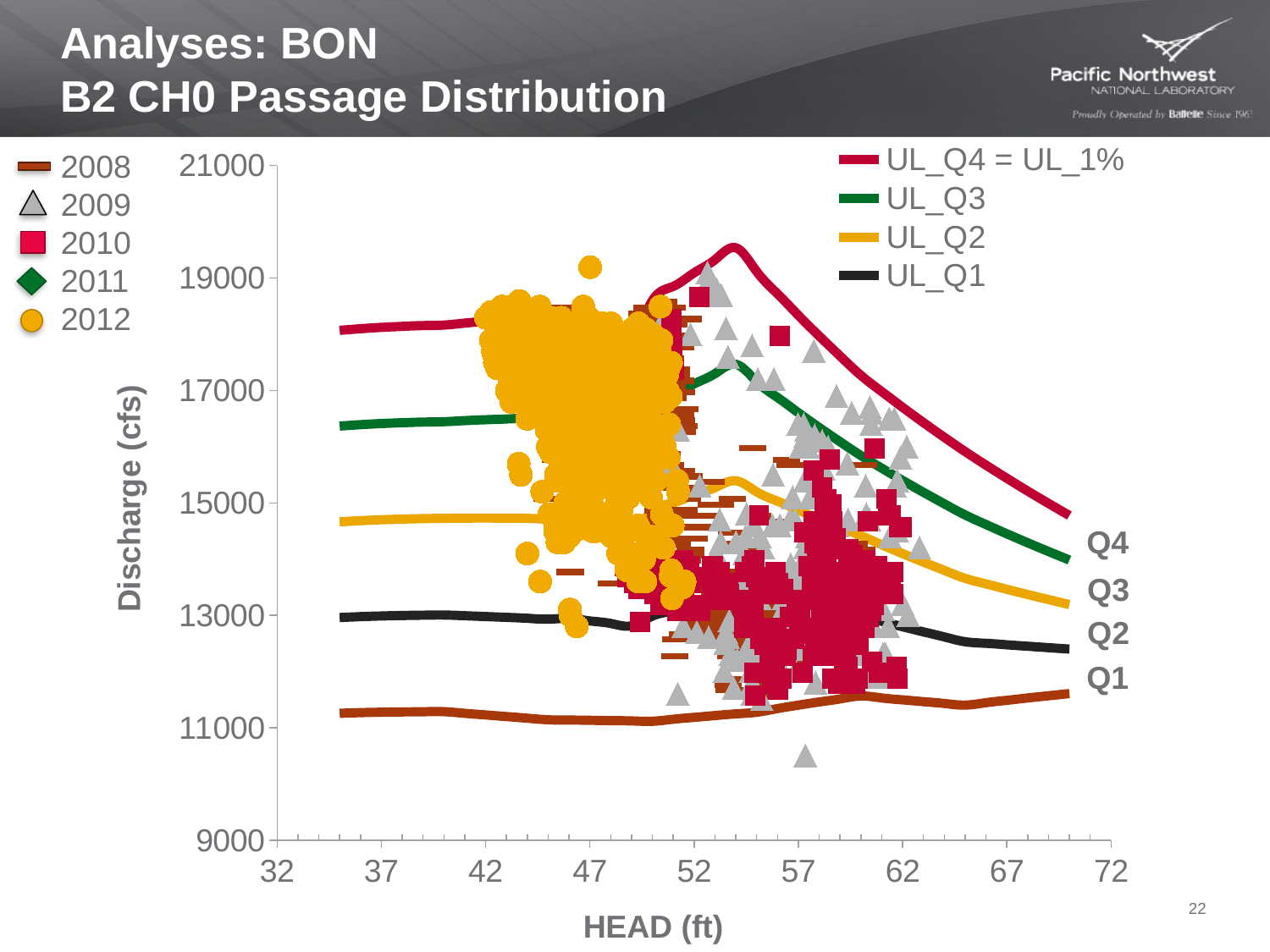
How many year series does the legend on the left list? 5 Is the UL_Q1 line at a head of 70 ft greater or less than 13000 cfs? less What is the label of the horizontal axis? HEAD (ft) Does the UL_Q4 line rise or fall as head increases from 54 ft to 70 ft? fall How many UL line series does the legend on the right list? 4 Is the UL_Q4 line at a head of 37 ft greater or less than 17000 cfs? greater Which line series lies highest on the chart across the head range? UL_Q4 = UL_1% Is the peak of the UL_Q4 line greater or less than 19000 cfs? greater What kind of chart is shown on the slide? scatter chart What is the label of the vertical axis? Discharge (cfs)